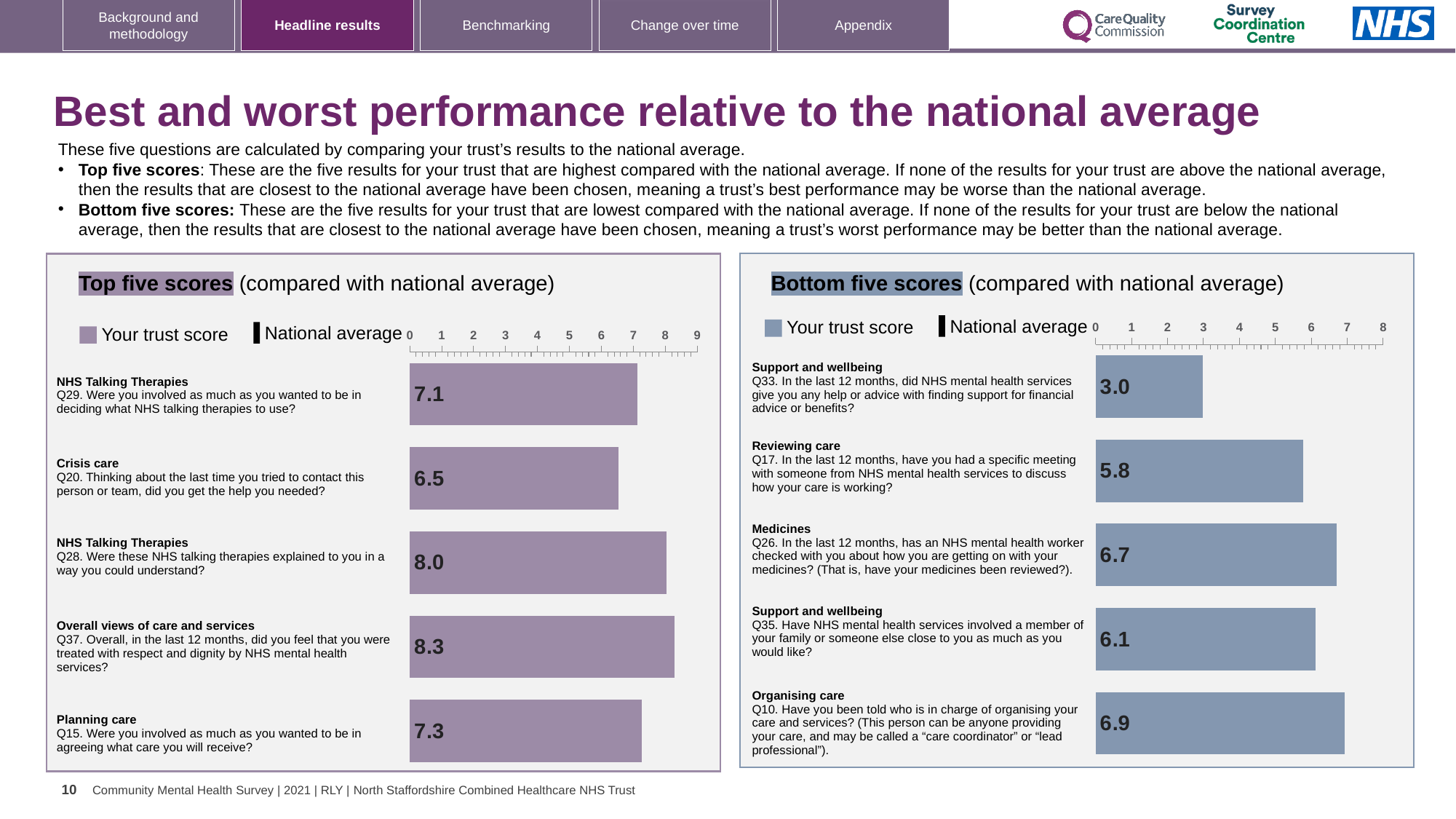
In the 'Bottom five scores' chart, which has the larger trust score: Q17 (Reviewing care) or Q35 (Support and wellbeing, involving family)? Q35 (Support and wellbeing) In the 'Top five scores' chart, which question has the highest trust score? Q37 (Overall views of care and services) How many questions are plotted in the 'Bottom five scores' chart? 5 In the 'Bottom five scores' chart, what is the trust score for Q33 (Support and wellbeing, help with financial advice or benefits)? 3.0 In the 'Bottom five scores' chart, which question has the highest trust score? Q10 (Organising care) In the 'Top five scores' chart, what is the difference between the trust scores for Q28 and Q15? 0.7 In the 'Bottom five scores' chart, what is the trust score for Q26 (Medicines)? 6.7 In the 'Top five scores' chart, what is the trust score for Q29 (NHS Talking Therapies, involved in deciding what talking therapies to use)? 7.1 What type of chart is the 'Top five scores' chart? Bar chart In the 'Top five scores' chart, what is the trust score for Q37 (Overall views of care and services)? 8.3 In the 'Bottom five scores' chart, which question has the lowest trust score? Q33 (Support and wellbeing) In the 'Top five scores' chart, which question has the lowest trust score? Q20 (Crisis care)